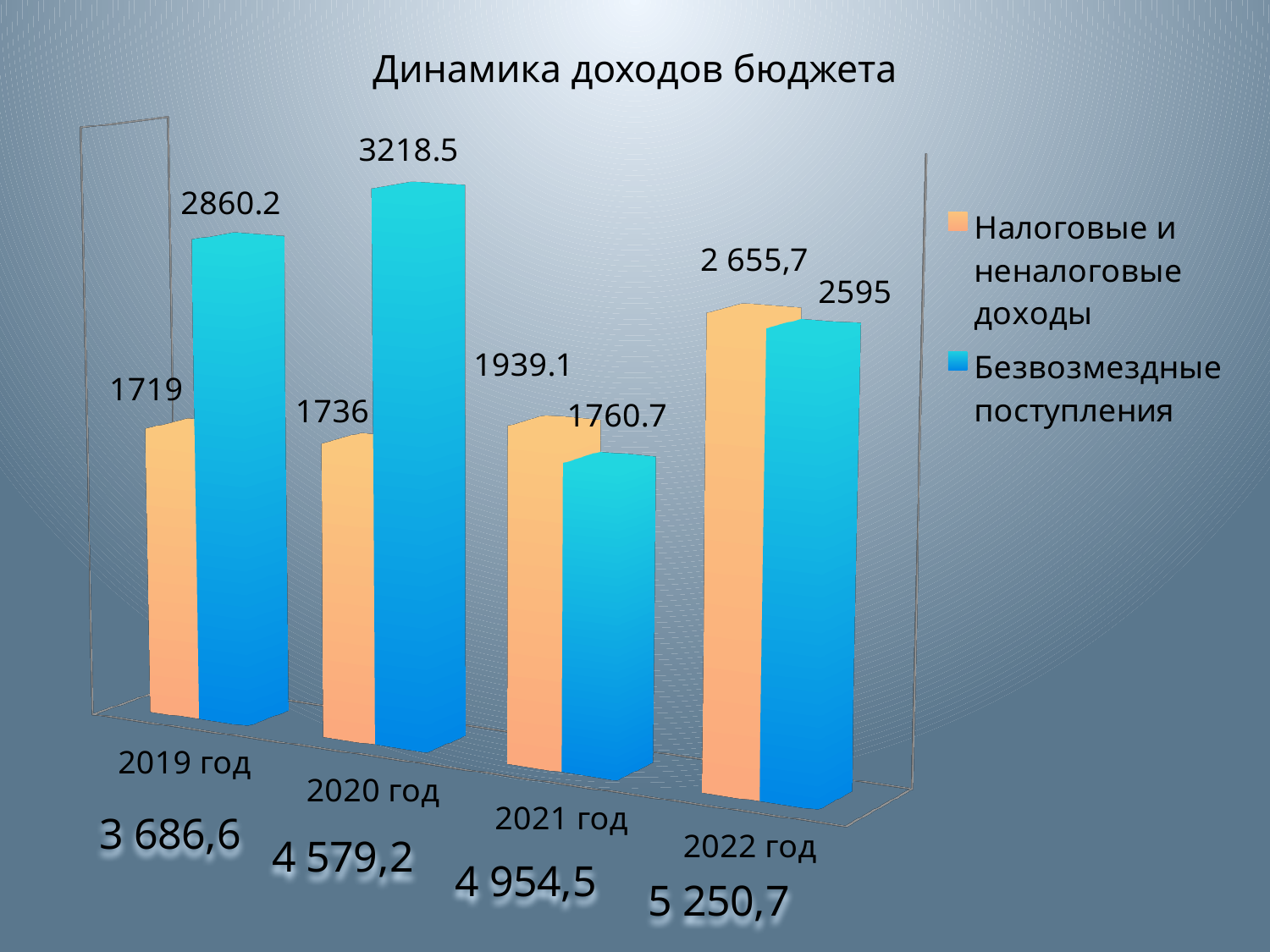
In which year is Налоговые и неналоговые доходы the lowest? 2019 год What is the value of Безвозмездные поступления for 2022 год? 2595 Which is larger in 2021 год: Налоговые и неналоговые доходы or Безвозмездные поступления? Налоговые и неналоговые доходы What is the value of Налоговые и неналоговые доходы for 2019 год? 1719 What is the difference between Безвозмездные поступления and Налоговые и неналоговые доходы in 2019 год? 1141.2 In which year is Безвозмездные поступления the highest? 2020 год What is the title of the chart? Динамика доходов бюджета What is the value of Безвозмездные поступления for 2020 год? 3218.5 How many series does the legend list? 2 How many year categories are shown on the x axis? 4 What type of chart is shown on the slide? bar chart Do the values of Налоговые и неналоговые доходы rise or fall from 2019 год to 2022 год? rise